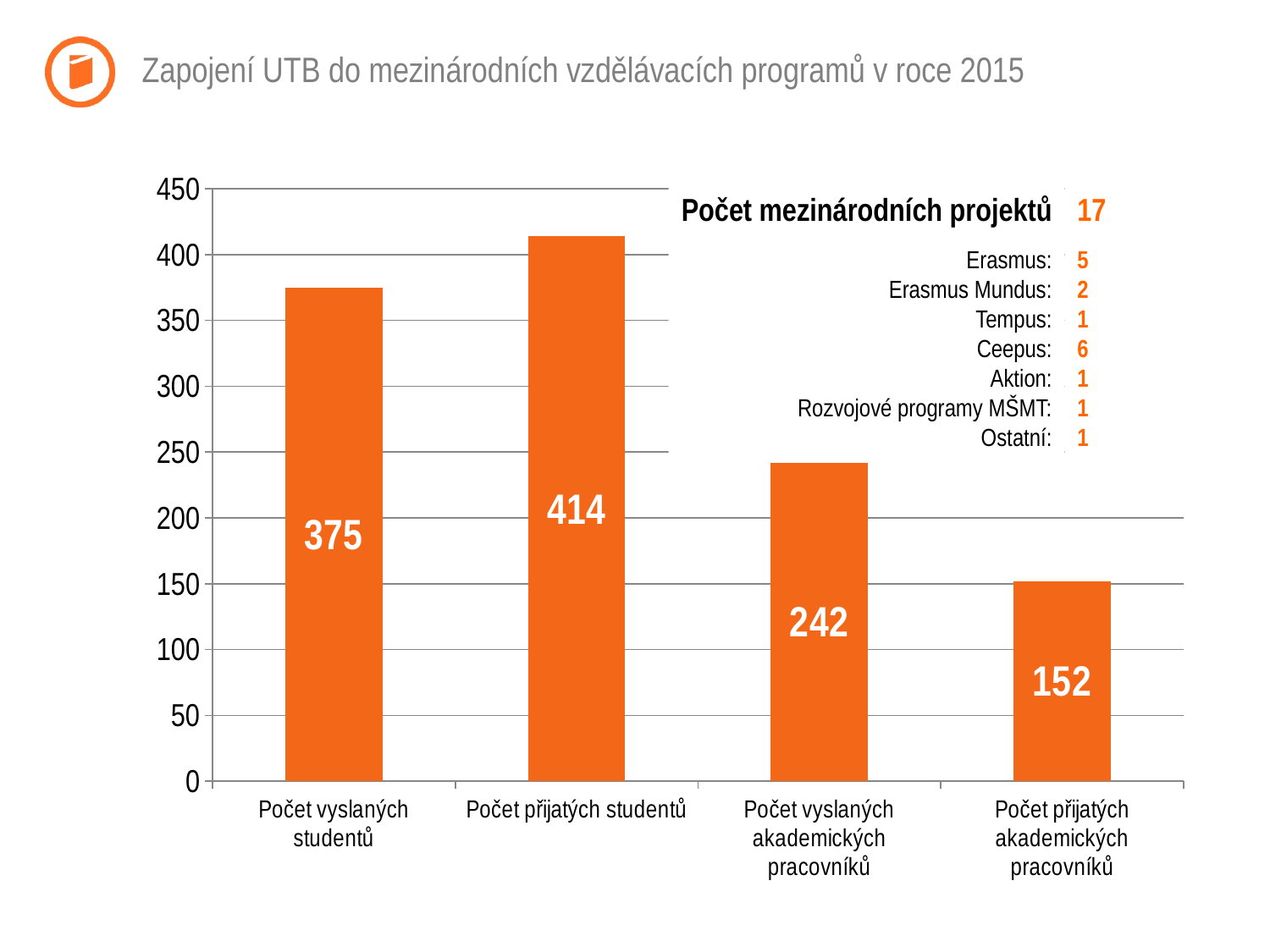
What is the value for Počet přijatých akademických pracovníků? 152 What is the value for Počet vyslaných studentů? 375 How many categories are shown on the x axis? 4 Is the value for Počet přijatých akademických pracovníků greater or less than 200? less Which is larger, Počet vyslaných studentů or Počet vyslaných akademických pracovníků? Počet vyslaných studentů What is the value for Počet vyslaných akademických pracovníků? 242 What is the value for Počet přijatých studentů? 414 Which category has the highest value? Počet přijatých studentů What is the difference between Počet přijatých studentů and Počet vyslaných studentů? 39 Which category has the lowest value? Počet přijatých akademických pracovníků What kind of chart is shown on the slide? bar chart What is the difference between Počet vyslaných akademických pracovníků and Počet přijatých akademických pracovníků? 90